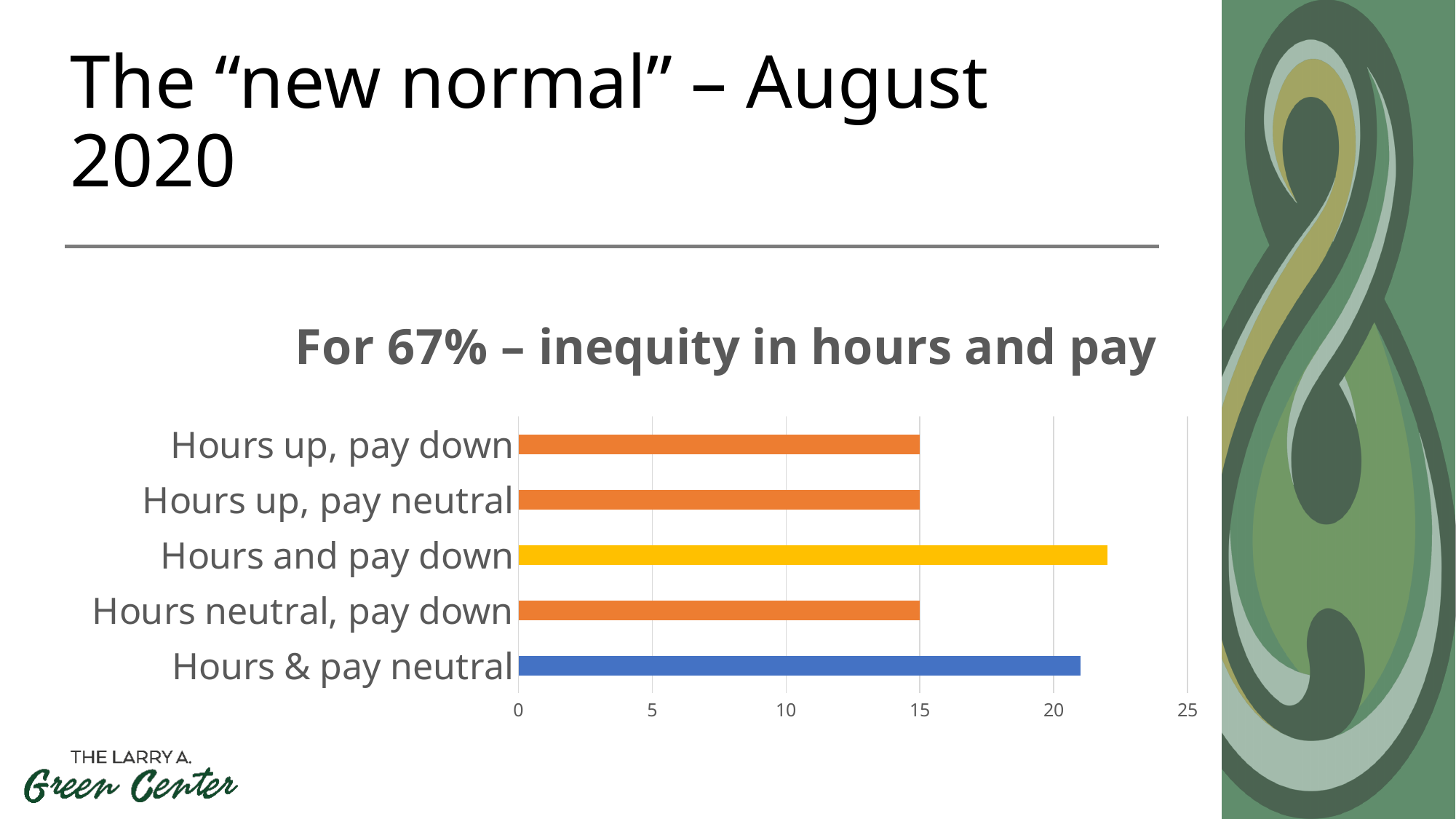
Which is larger: the value for "Hours and pay down" or the value for "Hours up, pay down"? Hours and pay down How many categories are plotted in the chart? 5 What is the value for "Hours up, pay down"? 15 What is the value for "Hours neutral, pay down"? 15 What type of chart is shown on the slide? Bar chart What is the value for "Hours up, pay neutral"? 15 Is the value for "Hours and pay down" greater or less than 20? greater Which category has the highest value? Hours and pay down Is the value for "Hours & pay neutral" greater or less than 20? greater Which is larger: the value for "Hours & pay neutral" or the value for "Hours neutral, pay down"? Hours & pay neutral What is the title of the chart? For 67% – inequity in hours and pay What colour is the bar for "Hours & pay neutral"? Blue